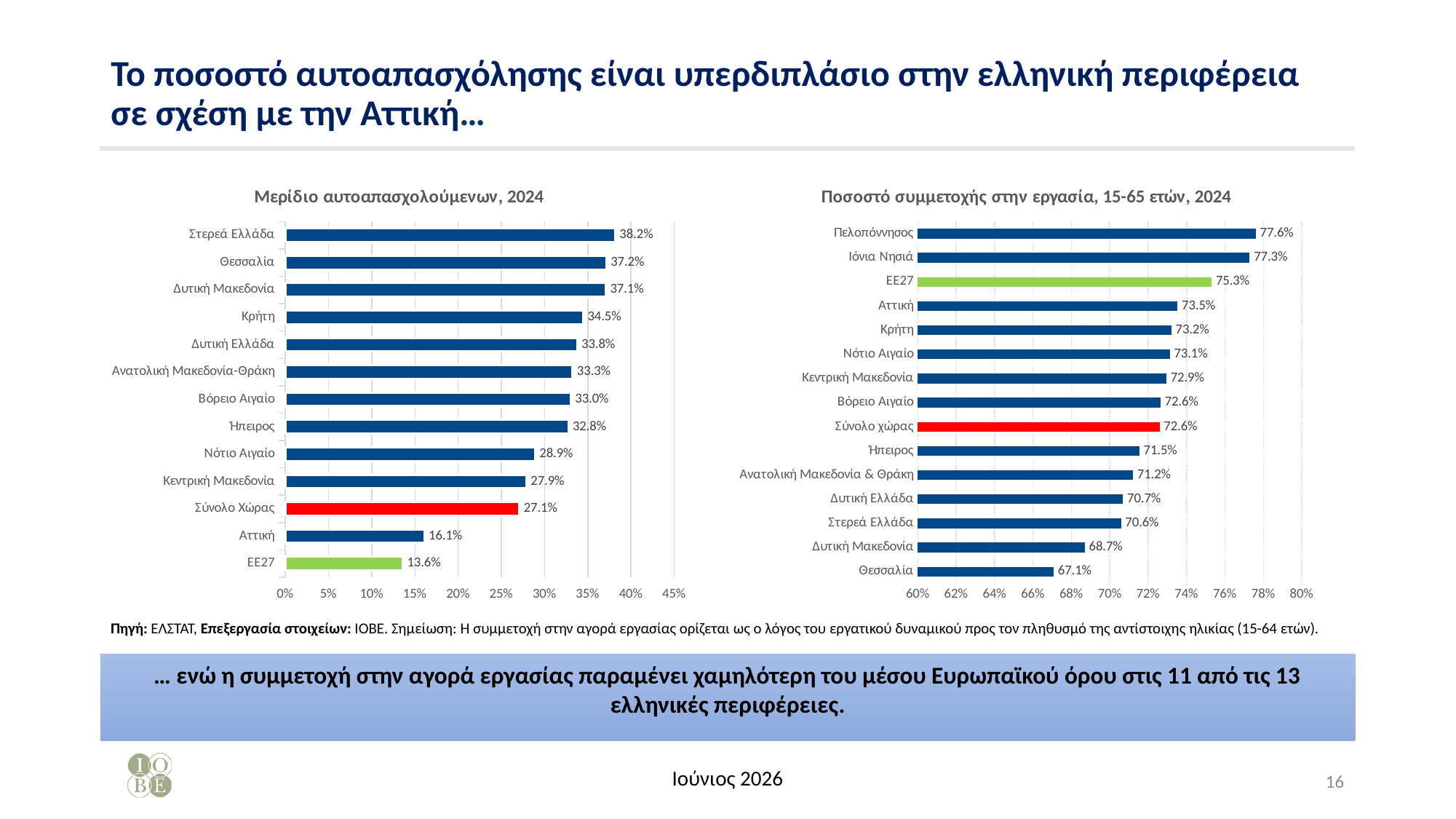
In the chart 'Ποσοστό συμμετοχής στην εργασία, 15-65 ετών, 2024', what is the value for ΕΕ27? 75.3% What type of chart is the chart on the left of the slide? Bar chart In the chart 'Μερίδιο αυτοαπασχολούμενων, 2024', what is the value for Στερεά Ελλάδα? 38.2% In the chart 'Μερίδιο αυτοαπασχολούμενων, 2024', what is the difference between Σύνολο Χώρας and Αττική? 11.0 percentage points In the chart 'Μερίδιο αυτοαπασχολούμενων, 2024', which category has the lowest value? ΕΕ27 In the chart 'Μερίδιο αυτοαπασχολούμενων, 2024', how many categories are shown? 13 In the chart 'Μερίδιο αυτοαπασχολούμενων, 2024', what is the value for Αττική? 16.1% In the chart 'Μερίδιο αυτοαπασχολούμενων, 2024', which is larger, Κρήτη or Δυτική Ελλάδα? Κρήτη In the chart 'Ποσοστό συμμετοχής στην εργασία, 15-65 ετών, 2024', how many categories are shown? 15 In the chart 'Ποσοστό συμμετοχής στην εργασία, 15-65 ετών, 2024', what is the difference between ΕΕ27 and Σύνολο χώρας? 2.7 percentage points In the chart 'Ποσοστό συμμετοχής στην εργασία, 15-65 ετών, 2024', what is the value for Πελοπόννησος? 77.6% In the chart 'Ποσοστό συμμετοχής στην εργασία, 15-65 ετών, 2024', which category has the lowest value? Θεσσαλία